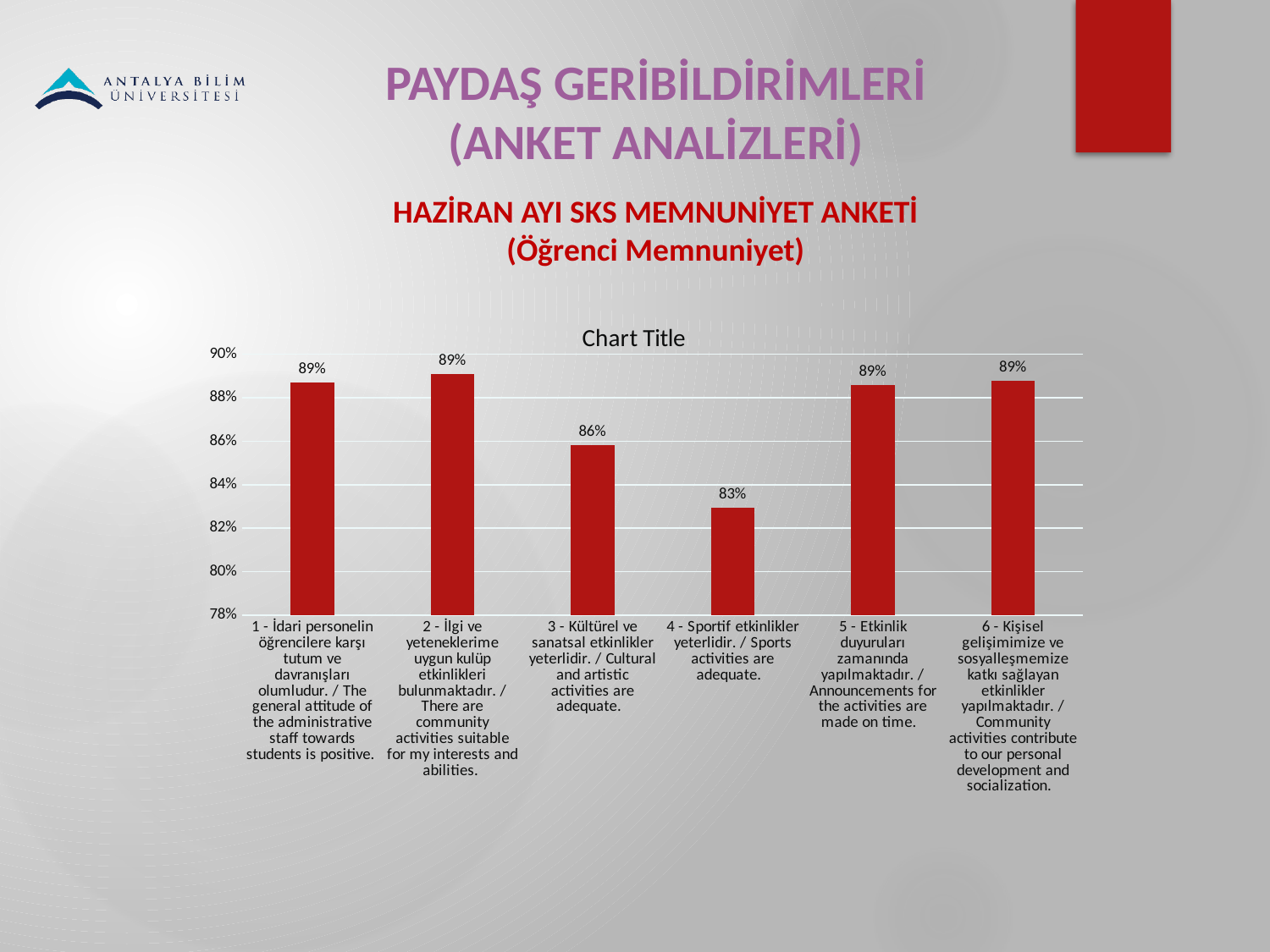
Which is larger, the value for category 3 or the value for category 4? Category 3 What is the difference between the value for category 3 and the value for category 4? 3 percentage points What is the value for category 1 (İdari personelin öğrencilere karşı tutum ve davranışları olumludur)? 89% What is the difference between the value for category 1 and the value for category 4? 6 percentage points What is the value for category 3 (Kültürel ve sanatsal etkinlikler yeterlidir / Cultural and artistic activities are adequate)? 86% What is the value for category 4 (Sportif etkinlikler yeterlidir / Sports activities are adequate)? 83% What is the value for category 5 (Etkinlik duyuruları zamanında yapılmaktadır / Announcements for the activities are made on time)? 89% How many categories are shown in the chart? 6 Which category has the lowest value? 4 - Sportif etkinlikler yeterlidir. / Sports activities are adequate. Is the value for category 4 greater or less than 84%? less What is the title shown above the chart? Chart Title What kind of chart is shown on the slide? Bar chart